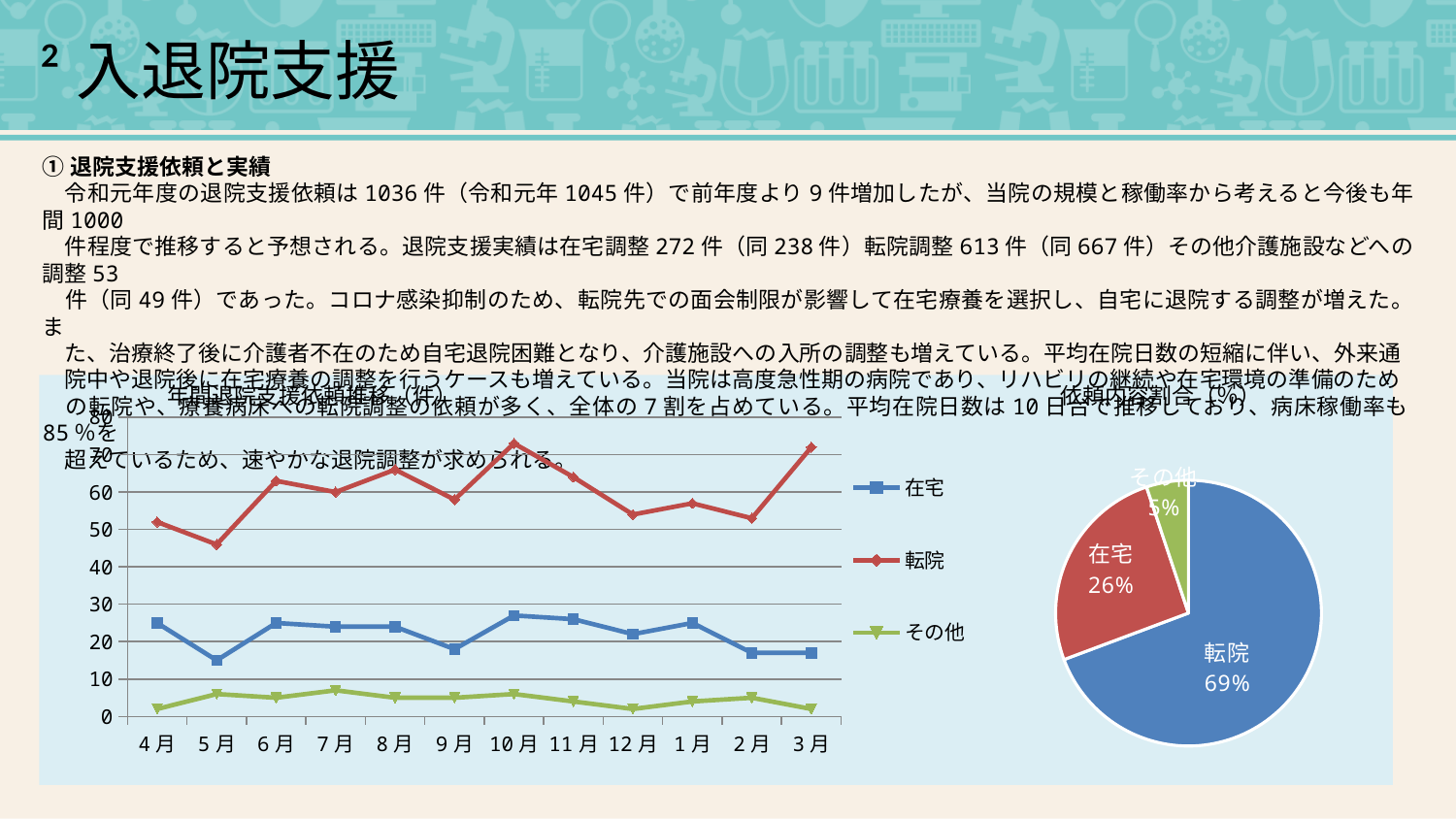
How many series does the legend of the line chart on the left list? 3 In the line chart on the left, which series has the higher value in 4月, 在宅 or 転院? 転院 In the pie chart on the right, which category has the largest slice? 転院 In the pie chart on the right, which category has the smallest slice? その他 What kind of chart is the chart on the left of the slide? line chart In the pie chart on the right, how many percentage points larger is 転院 than 在宅? 43% How many months are shown on the x axis of the line chart on the left? 12 In the line chart on the left, is the value for 在宅 in 5月 greater or less than 20? less In the pie chart on the right, what share does 在宅 have? 26% In the line chart on the left, is the value for 転院 in 10月 greater or less than 60? greater In the pie chart on the right, what share does その他 have? 5% In the pie chart on the right, what share does 転院 have? 69%